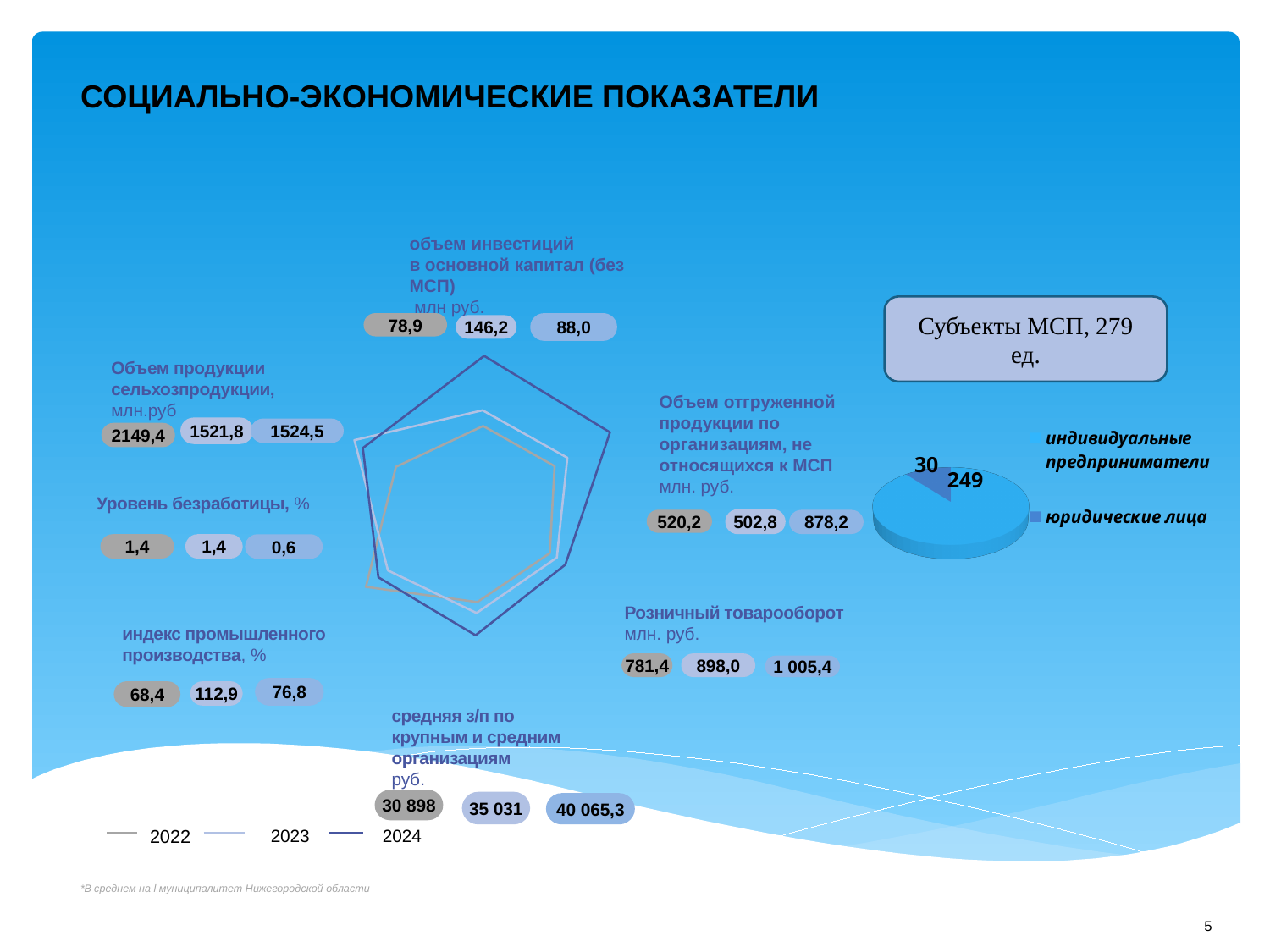
On the pie chart 'Субъекты МСП, 279 ед.', what is the total of the two slices? 279 On the radar chart in the centre of the slide, what is the difference between the 2023 and 2022 values of 'объем инвестиций в основной капитал (без МСП)'? 67,3 On the radar chart in the centre of the slide, what is the value of 'Уровень безработицы, %' for 2024? 0,6 On the pie chart 'Субъекты МСП, 279 ед.', which slice is larger: индивидуальные предприниматели or юридические лица? индивидуальные предприниматели On the pie chart 'Субъекты МСП, 279 ед.', what is the value for индивидуальные предприниматели? 249 On the radar chart in the centre of the slide, how many series does the legend list? 3 On the radar chart in the centre of the slide, does 'Розничный товарооборот' rise or fall from 2022 to 2024? Rises On the radar chart in the centre of the slide, what is the value of 'средняя з/п по крупным и средним организациям' for 2024? 40 065,3 What kind of chart is the chart in the centre of the slide with the 2022, 2023 and 2024 legend? Radar chart What kind of chart is the chart on the right of the slide showing Субъекты МСП? Pie chart On the pie chart 'Субъекты МСП, 279 ед.', what is the value for юридические лица? 30